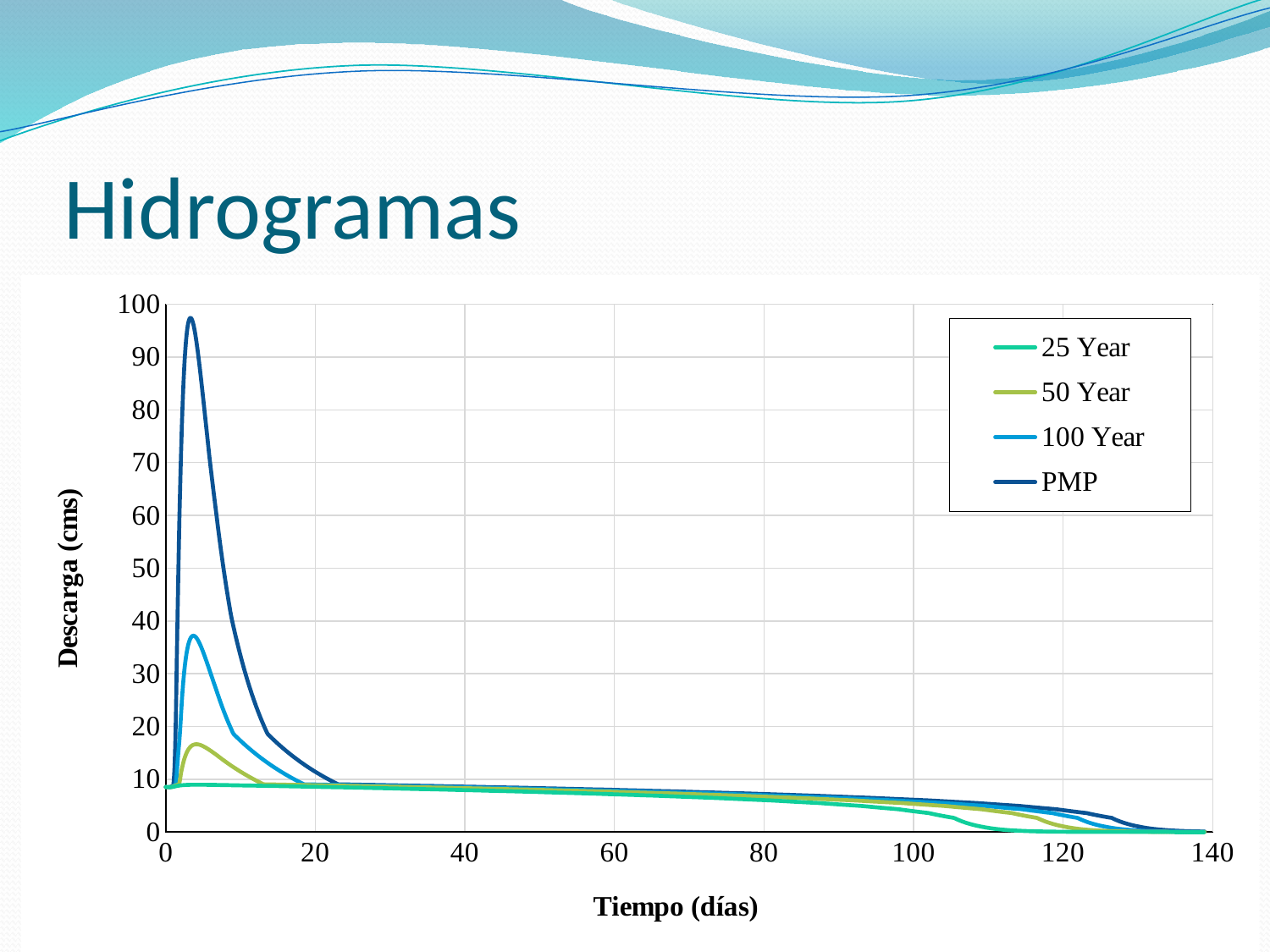
Is the peak value of the 100 Year series greater or less than 30? greater After its peak near the start, does the PMP series rise or fall as time increases? fall How many series does the legend list? 4 Which series has the lowest peak discharge? 25 Year Which series has a higher peak, 100 Year or 50 Year? 100 Year Is the peak value of the 100 Year series greater or less than 40? less What kind of chart is shown on the slide? line chart Is the peak value of the 50 Year series greater or less than 10? greater What is the title of the y axis? Descarga (cms) Which series reaches the highest peak discharge? PMP What is the title of the x axis? Tiempo (días)